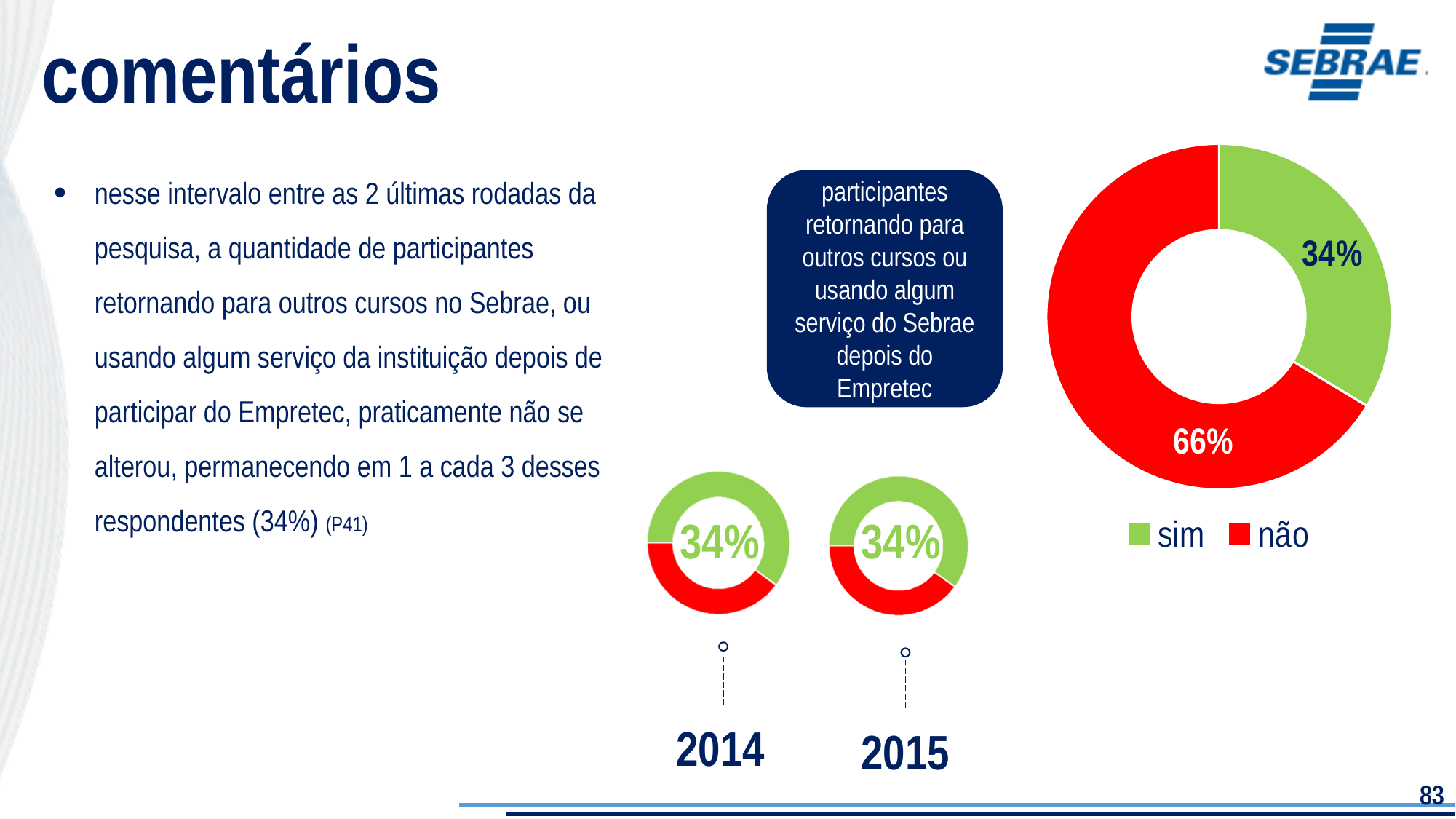
In the large donut chart on the right, what percentage is shown for "sim"? 34% How many small donut charts with year labels are shown below the large donut chart? 2 In the small donut chart labelled 2015, what percentage is printed in the centre? 34% In the large donut chart on the right, which category has the smallest share? sim Comparing the small donut charts for 2014 and 2015, did the percentage shown rise, fall or stay the same? Stayed the same What kind of chart is the large chart on the right of the slide? Donut (pie) chart In the large donut chart on the right, which category has the larger share, "sim" or "não"? não In the large donut chart on the right, what is the difference in percentage points between "não" and "sim"? 32 In the small donut chart labelled 2014, what percentage is printed in the centre? 34% In the legend of the large donut chart on the right, which colour represents "não"? Red How many entries does the legend of the large donut chart on the right list? 2 In the large donut chart on the right, what percentage is shown for "não"? 66%